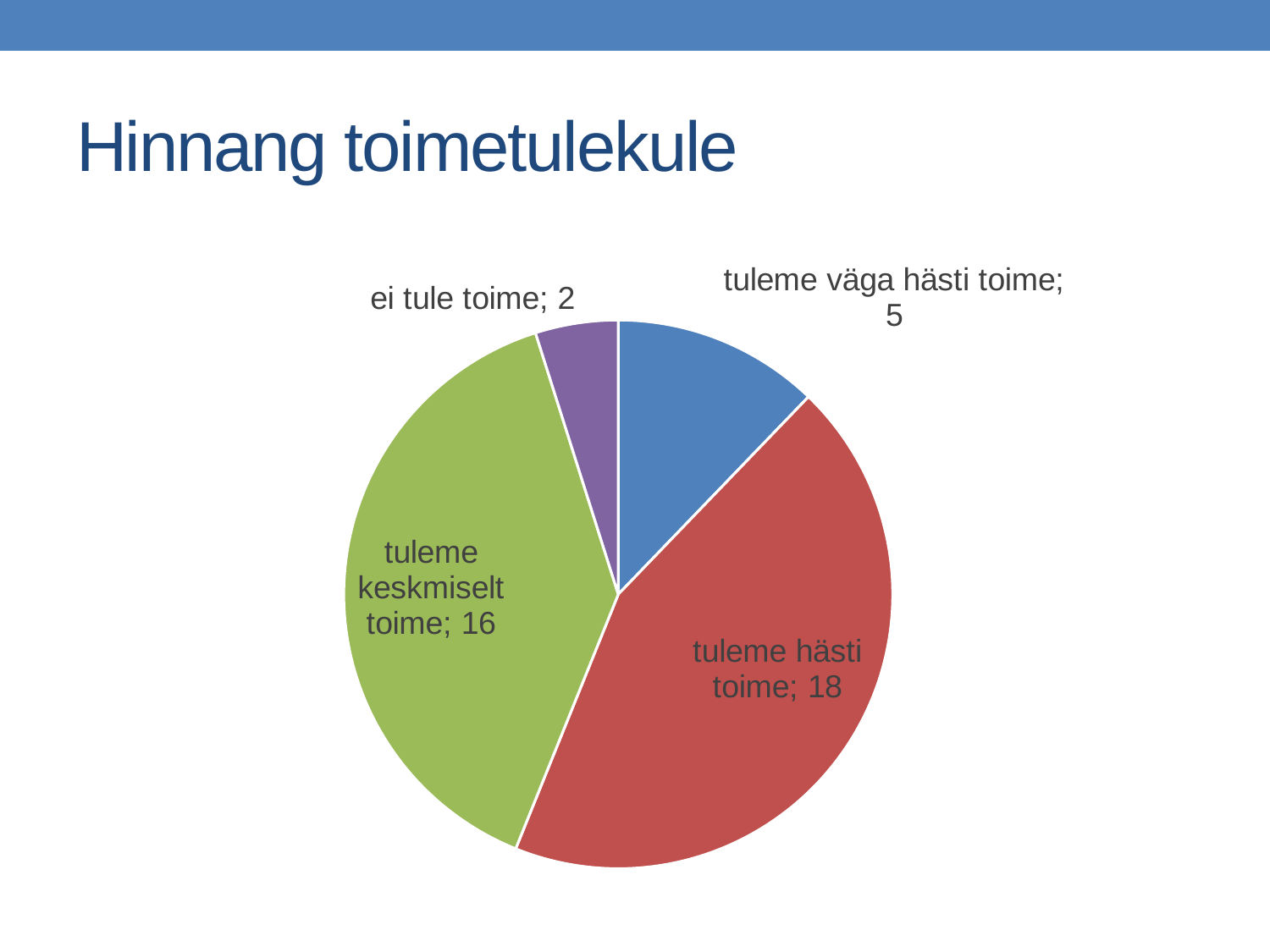
What is the value for "ei tule toime"? 2 What is the difference between the values for "tuleme hästi toime" and "tuleme keskmiselt toime"? 2 Which category has the largest slice of the pie? tuleme hästi toime What is the value for "tuleme keskmiselt toime"? 16 Which is larger, the value for "tuleme väga hästi toime" or the value for "ei tule toime"? tuleme väga hästi toime What is the value for "tuleme hästi toime"? 18 What is the difference between the values for "tuleme väga hästi toime" and "ei tule toime"? 3 What type of chart is shown on the slide? pie chart How many slices does the pie chart have? 4 Which category has the smallest slice of the pie? ei tule toime What is the value for "tuleme väga hästi toime"? 5 What is the title of the slide containing the pie chart? Hinnang toimetulekule